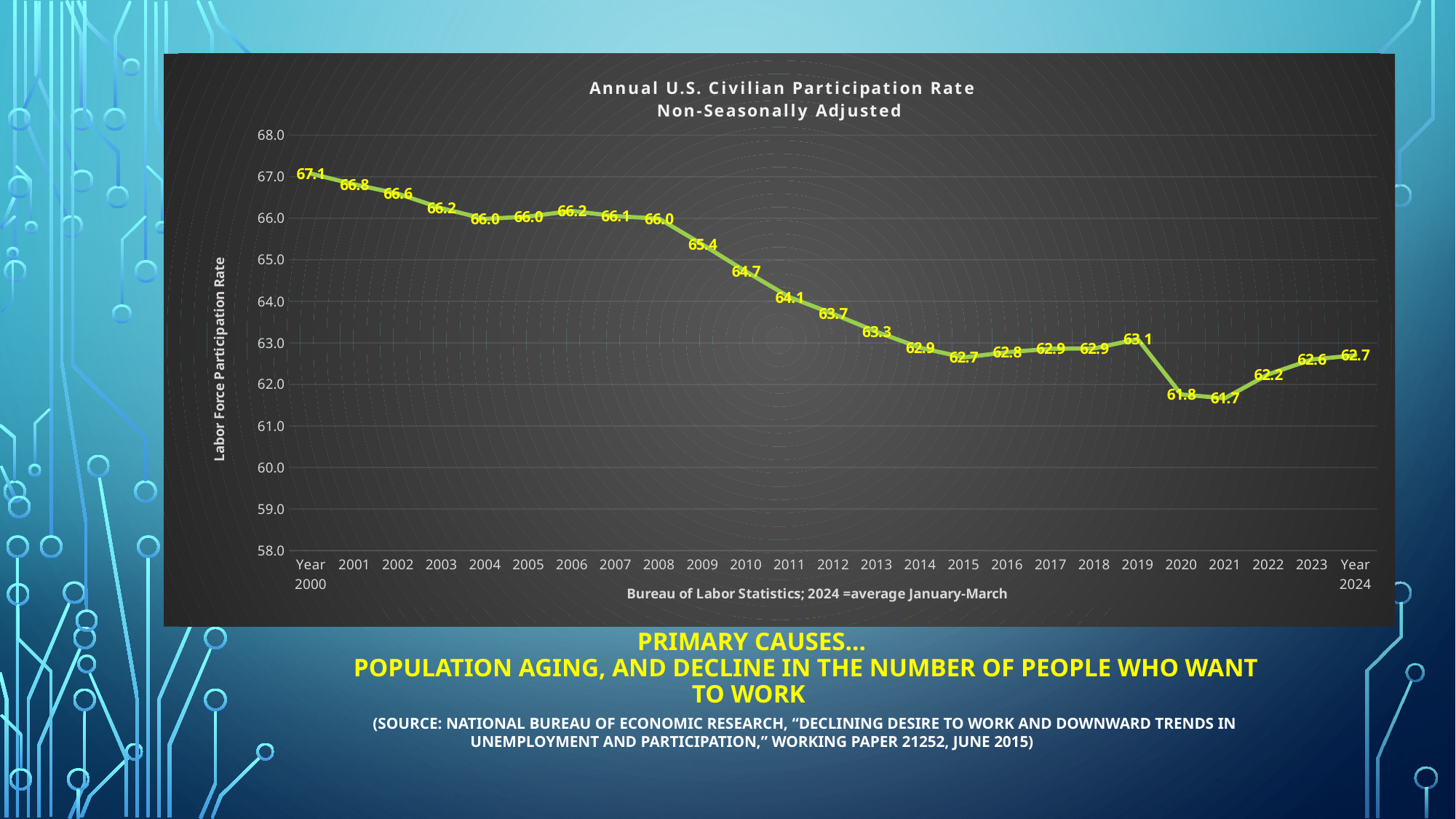
How many years are plotted on the chart? 25 What is the labor force participation rate for 2000? 67.1 What type of chart is shown on the slide? line chart What is the difference between the participation rate in 2019 and in 2020? 1.3 Which year has the highest participation rate? 2000 What is the labor force participation rate for 2024? 62.7 What is the overall trend of the participation rate from 2000 to 2024? falling Which year has a higher participation rate, 2010 or 2013? 2010 What is the difference between the participation rate in 2000 and in 2024? 4.4 What is the labor force participation rate for 2020? 61.8 Which year has the lowest participation rate? 2021 What is the labor force participation rate for 2009? 65.4